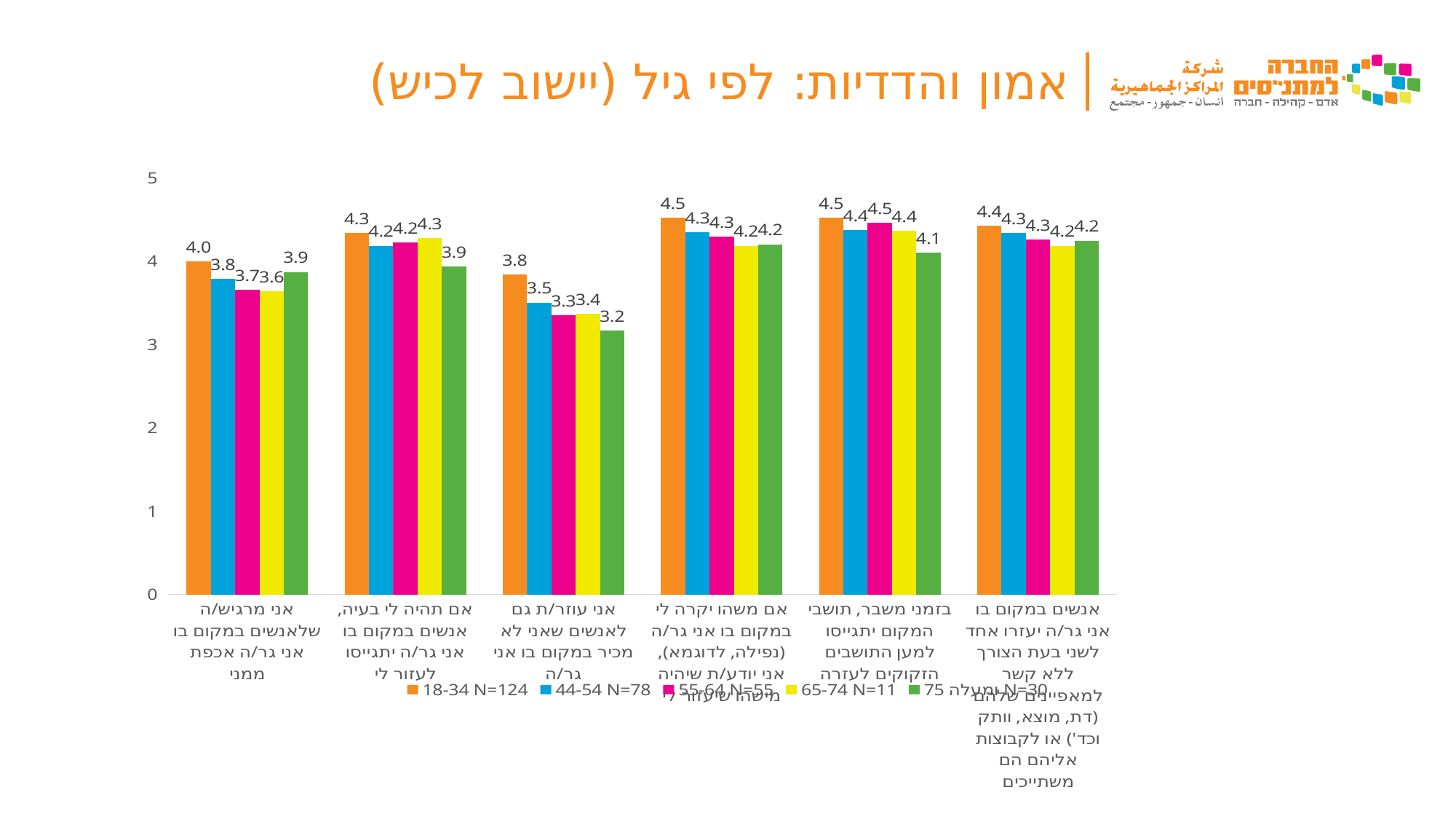
What is the value for the 65-74 N=11 series in the category 'אם תהיה לי בעיה, אנשים במקום בו אני גר/ה יתגייסו לעזור לי'? 4.3 What is the difference between the 18-34 N=124 value and the 75 ומעלה N=30 value in the category 'אני עוזר/ת גם לאנשים שאני לא מכיר במקום בו אני גר/ה'? 0.6 In the category 'בזמני משבר, תושבי המקום יתגייסו למען התושבים הזקוקים לעזרה', which is larger: the 44-54 N=78 value or the 75 ומעלה N=30 value? 44-54 N=78 Which series has the highest value in the category 'אם משהו יקרה לי במקום בו אני גר/ה (נפילה, לדוגמא), אני יודע/ת שיהיה מישהו שיעזור לי'? 18-34 N=124 What is the value for the 75 ומעלה N=30 series in the category 'אני עוזר/ת גם לאנשים שאני לא מכיר במקום בו אני גר/ה'? 3.2 What is the value for the 18-34 N=124 series in the category 'אני מרגיש/ה שלאנשים במקום בו אני גר/ה אכפת ממני'? 4.0 Is the value for the 55-64 N=55 series in the category 'אני מרגיש/ה שלאנשים במקום בו אני גר/ה אכפת ממני' greater or less than 4? less Which series has the lowest value in the category 'אני עוזר/ת גם לאנשים שאני לא מכיר במקום בו אני גר/ה'? 75 ומעלה N=30 What type of chart is shown on the slide? bar chart What is the title of the chart on the slide? אמון והדדיות: לפי גיל (יישוב לכיש) How many categories (statements) are shown on the x axis? 6 How many series does the legend list? 5